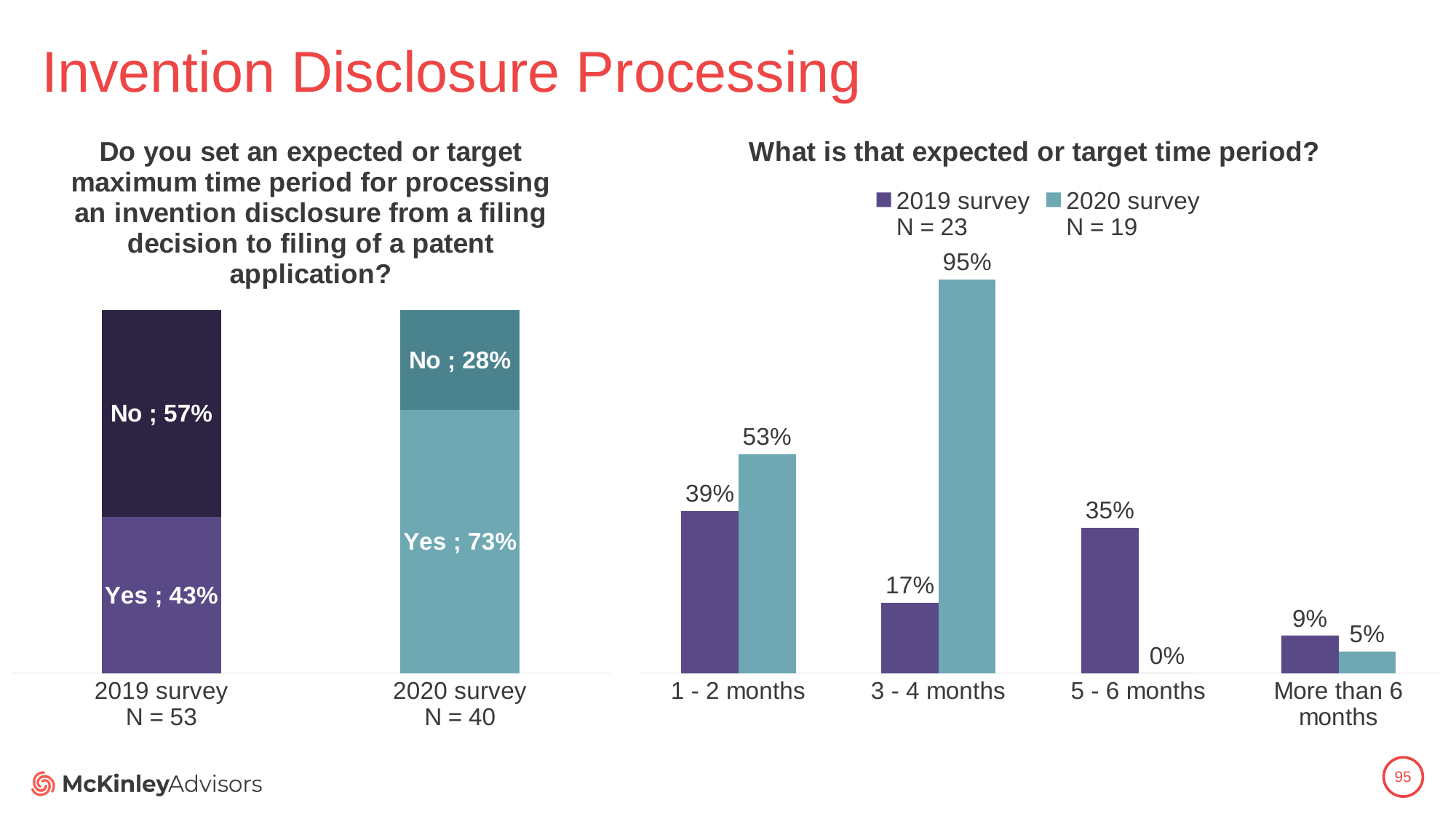
In the left chart, which survey year had the larger Yes share, 2019 or 2020? 2020 survey In the right chart, what is the difference between the 2020 survey and 2019 survey values for 1 - 2 months? 14% In the right chart, what percentage of 2020 survey respondents chose 3 - 4 months? 95% In the right chart, which time period has the highest value for the 2019 survey? 1 - 2 months In the left chart, what is the difference between the No share in the 2019 survey and the No share in the 2020 survey? 29% What type of chart is the left chart? Stacked bar chart In the left chart, what percentage of 2020 survey respondents answered No? 28% In the right chart, what percentage of 2019 survey respondents chose 5 - 6 months? 35% In the right chart, which time period has the lowest value for the 2020 survey? 5 - 6 months In the left chart, what percentage of 2019 survey respondents answered Yes? 43% How many series does the legend of the right chart list? 2 How many time period categories are shown in the right chart? 4